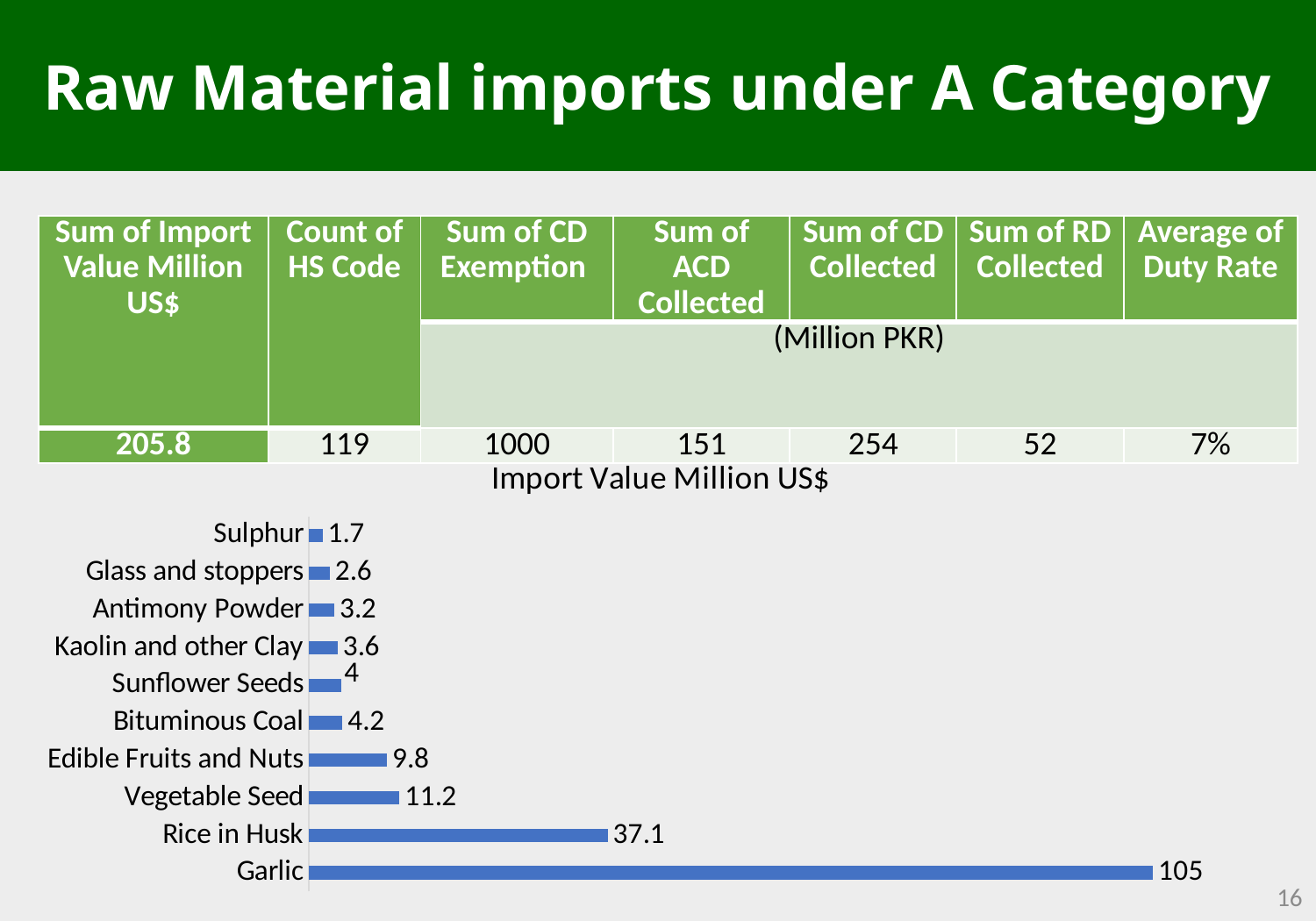
What is the import value for Vegetable Seed? 11.2 Which category has the lowest import value? Sulphur What is the import value for Sulphur? 1.7 What type of chart is shown on the slide? Bar chart What is the import value for Garlic? 105 How many categories are shown in the chart? 10 What is the title of the chart? Import Value Million US$ What is the difference between the import values of Garlic and Rice in Husk? 67.9 Which has a larger import value, Edible Fruits and Nuts or Bituminous Coal? Edible Fruits and Nuts What is the difference between the import values of Vegetable Seed and Edible Fruits and Nuts? 1.4 Which category has the highest import value? Garlic What is the import value for Rice in Husk? 37.1